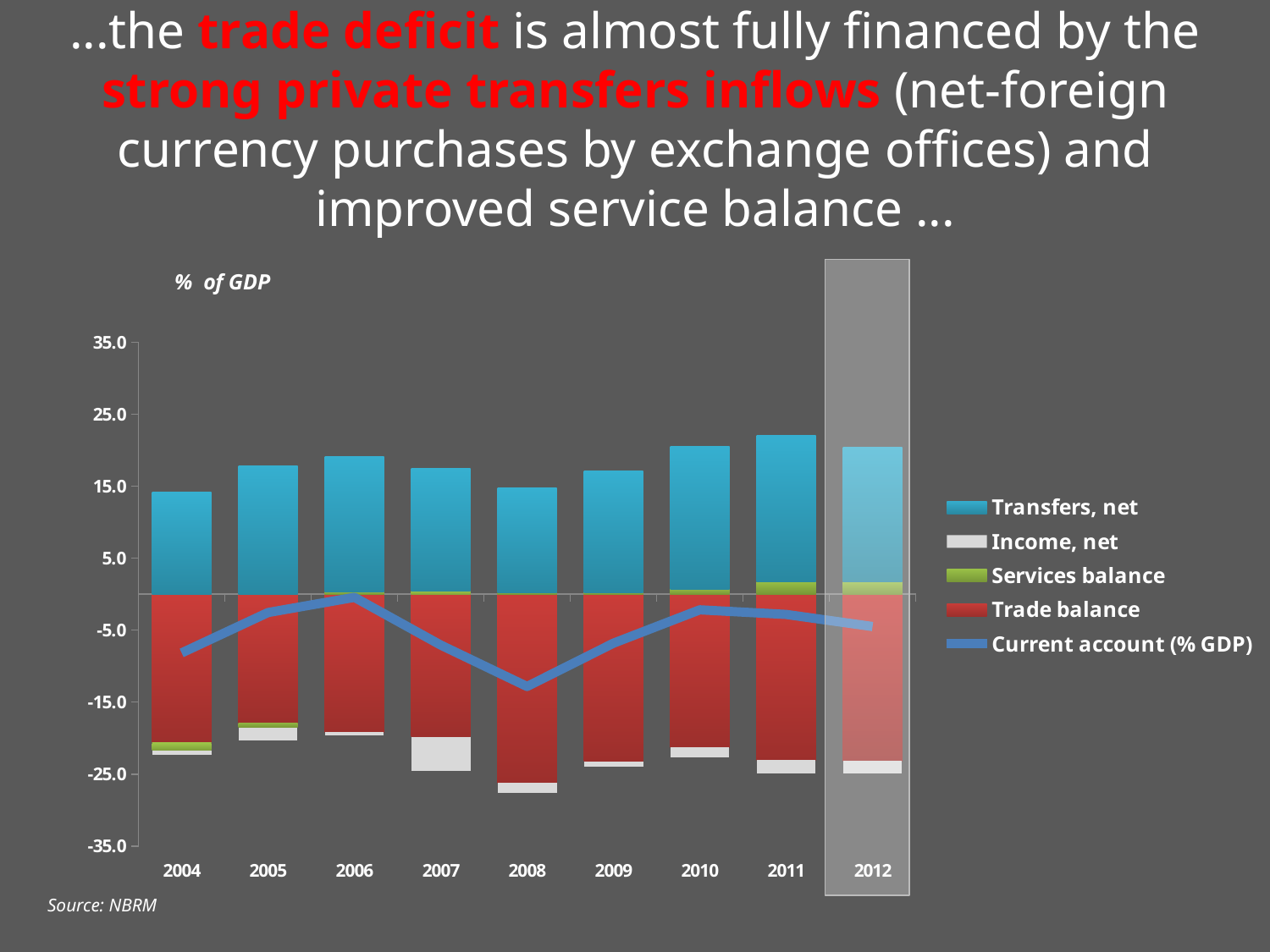
Is the Transfers, net value for 2011 greater or less than 15.0? greater How many years are shown on the x axis of the chart? 9 What kind of chart is shown on the slide? stacked bar chart with a line Which year has the larger Transfers, net value, 2004 or 2011? 2011 Is the Current account (% GDP) value for 2008 greater or less than -5.0? less In which year is the Trade balance bar the most negative? 2008 Does the Current account (% GDP) line rise or fall from 2008 to 2010? rise In which year does the Current account (% GDP) line reach its lowest point? 2008 Which year is highlighted with a grey shaded column on the chart? 2012 How many series does the chart legend list? 5 In which year is the Transfers, net bar the highest? 2011